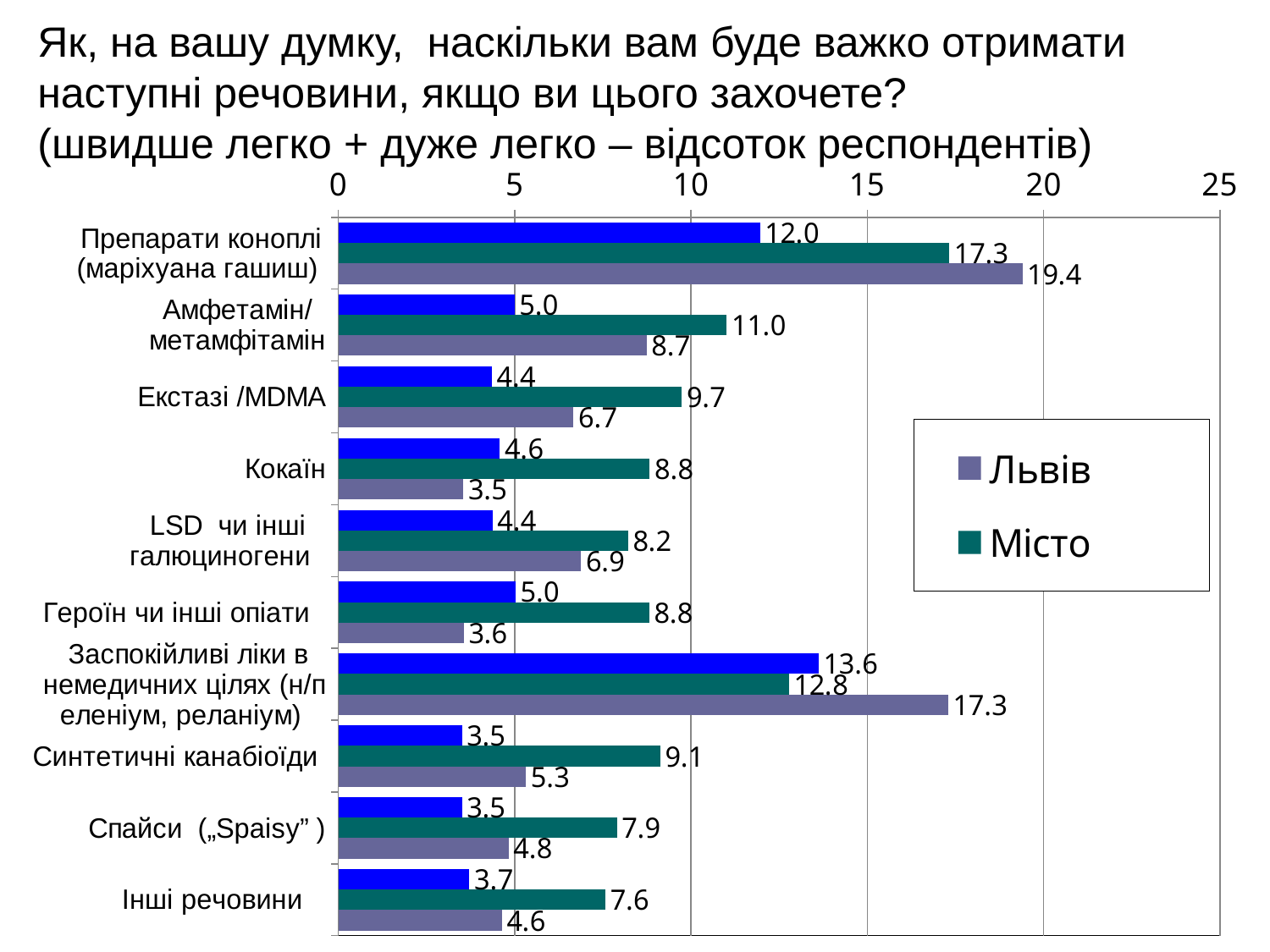
Is the value for Львів for Амфетамін/метамфітамін greater or less than 10? less Which category has the highest value for Львів? Препарати коноплі (маріхуана гашиш) Which category has the lowest value for Місто? Інші речовини How many categories are shown on the chart? 10 What is the value for Місто for Амфетамін/метамфітамін? 11.0 What is the value for Львів for Заспокійливі ліки в немедичних цілях? 17.3 What is the difference between the Львів and Місто values for Препарати коноплі (маріхуана гашиш)? 2.1 What is the value for Місто for Спайси („Spaisy”)? 7.9 What kind of chart is shown on the slide? bar chart What is the value for Львів for Препарати коноплі (маріхуана гашиш)? 19.4 For Кокаїн, which is larger: the value for Львів or the value for Місто? Місто How many series does the legend list? 2